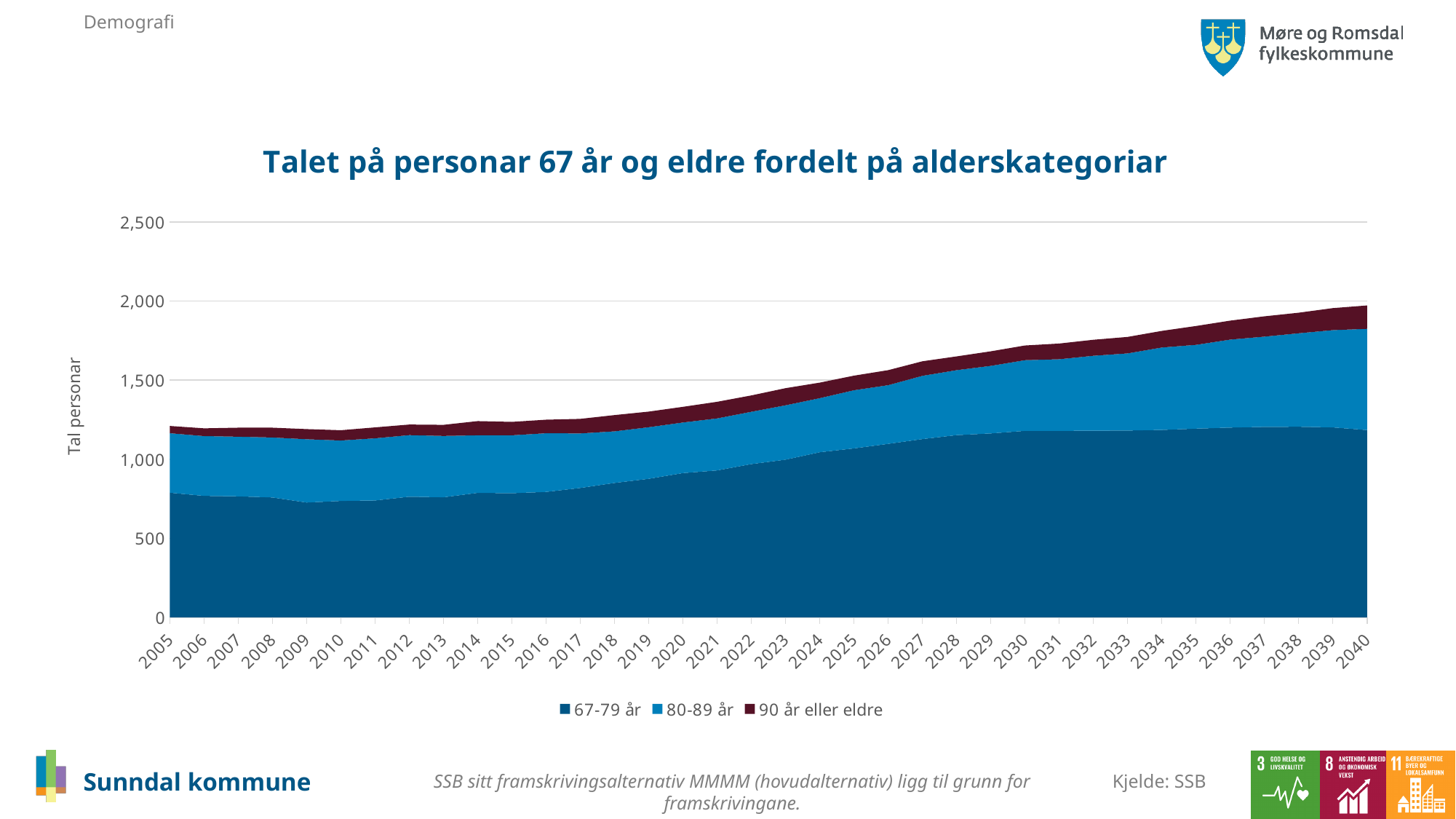
Is the value for 67-79 år in 2040 greater or less than 1,000? greater How many years are shown along the x axis? 36 What is the label on the vertical axis? Tal personar Is the value for 67-79 år in 2005 greater or less than 1,000? less Is the total number of persons 67 år og eldre in 2020 greater or less than 1,500? less How many series does the legend list? 3 Which series is the largest in 2040: 67-79 år or 90 år eller eldre? 67-79 år What is the title of the chart? Talet på personar 67 år og eldre fordelt på alderskategoriar Does the total number of persons 67 år og eldre rise or fall from 2005 to 2040? rise What kind of chart is shown on the slide? Stacked area chart